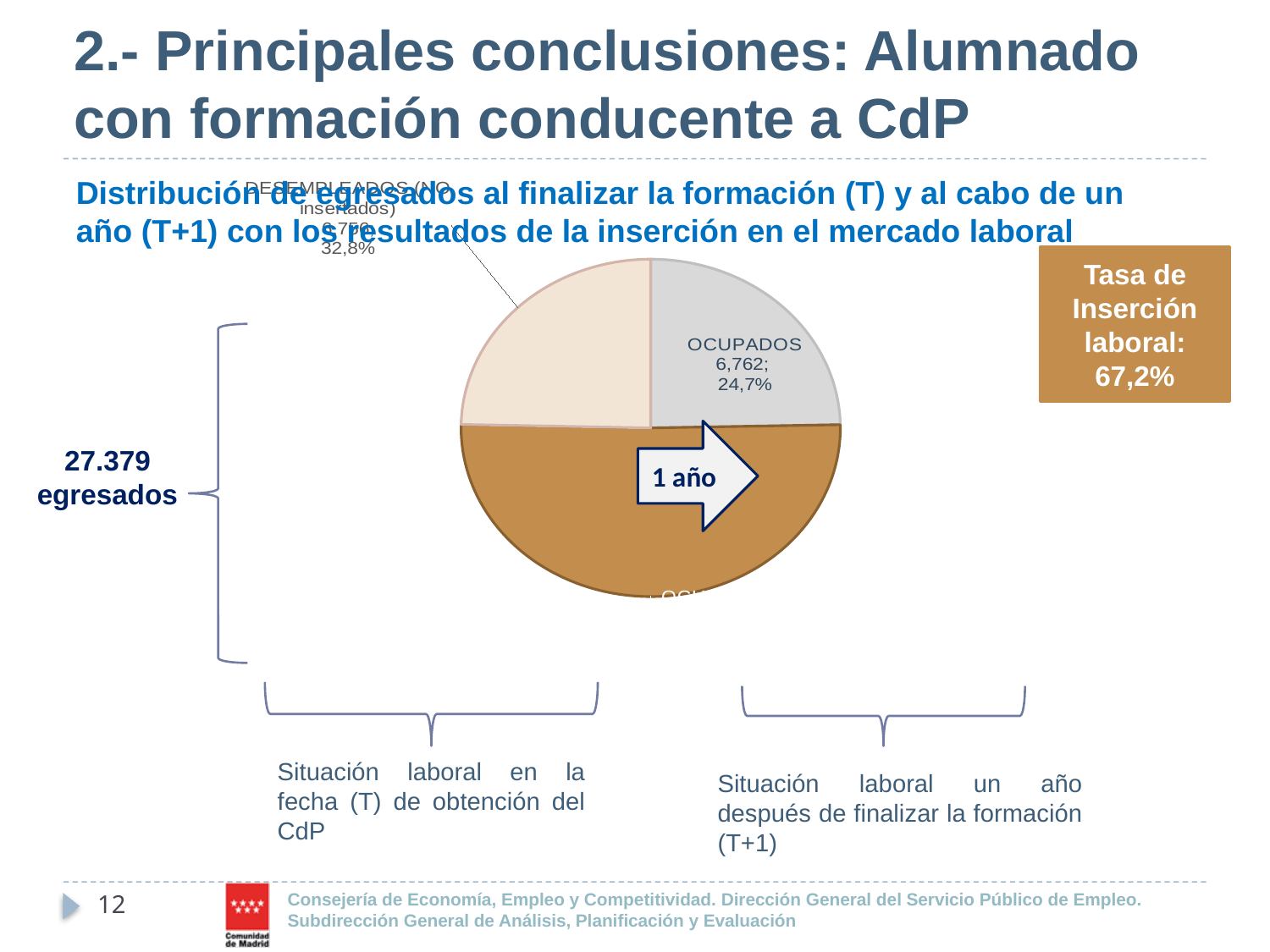
What text is written on the arrow placed over the pie chart? 1 año What kind of chart is shown on the slide? pie chart What share of the pie does the OCUPADOS slice represent? 24,7% What colour is the OCUPADOS slice of the pie chart? grey What is the number of egresados in the OCUPADOS slice of the pie chart? 6,762 How many slices does the pie chart have? 3